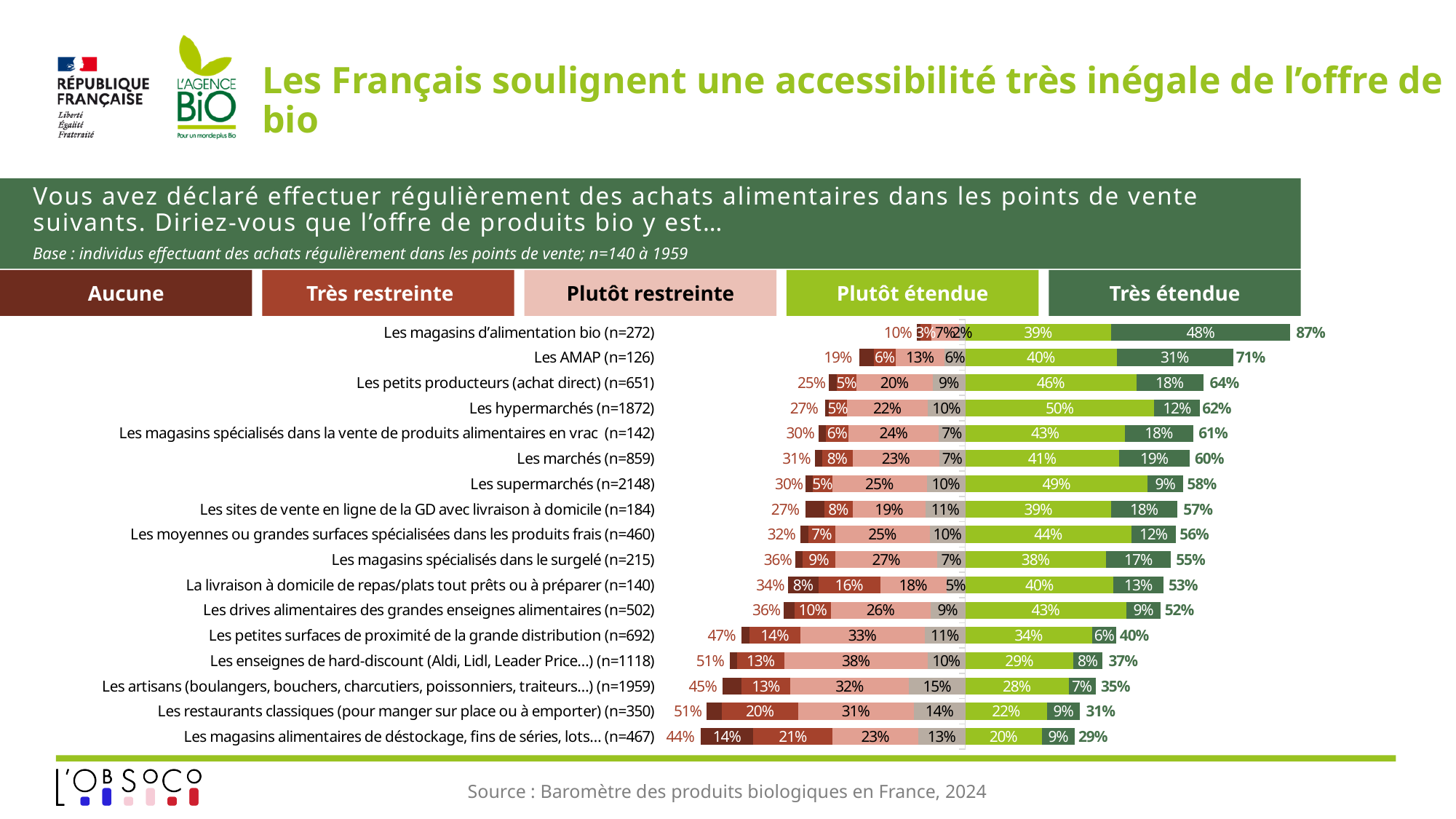
What kind of chart is shown on the slide? Stacked bar chart Which point of sale has the lowest 'Plutôt étendue' value? Les magasins alimentaires de déstockage, fins de séries, lots... (n=467) What is the difference in percentage points between the 'Très étendue' value for Les AMAP (31%) and for Les petits producteurs (achat direct) (18%)? 13 percentage points What is the bold percentage shown at the right end of the bar for Les AMAP (n=126)? 71% How many points of sale (categories) are listed in the chart? 17 What is the 'Plutôt étendue' value for Les hypermarchés (n=1872)? 50% What is the 'Très étendue' value for Les magasins d'alimentation bio (n=272)? 48% What is the 'Aucune' value for Les magasins alimentaires de déstockage, fins de séries, lots... (n=467)? 14% Which has the larger 'Plutôt restreinte' value: Les enseignes de hard-discount or Les artisans? Les enseignes de hard-discount Which point of sale has the highest 'Très étendue' value? Les magasins d'alimentation bio (n=272) How many response categories does the legend list? 5 What is the 'Très restreinte' value for Les restaurants classiques (n=350)? 20%